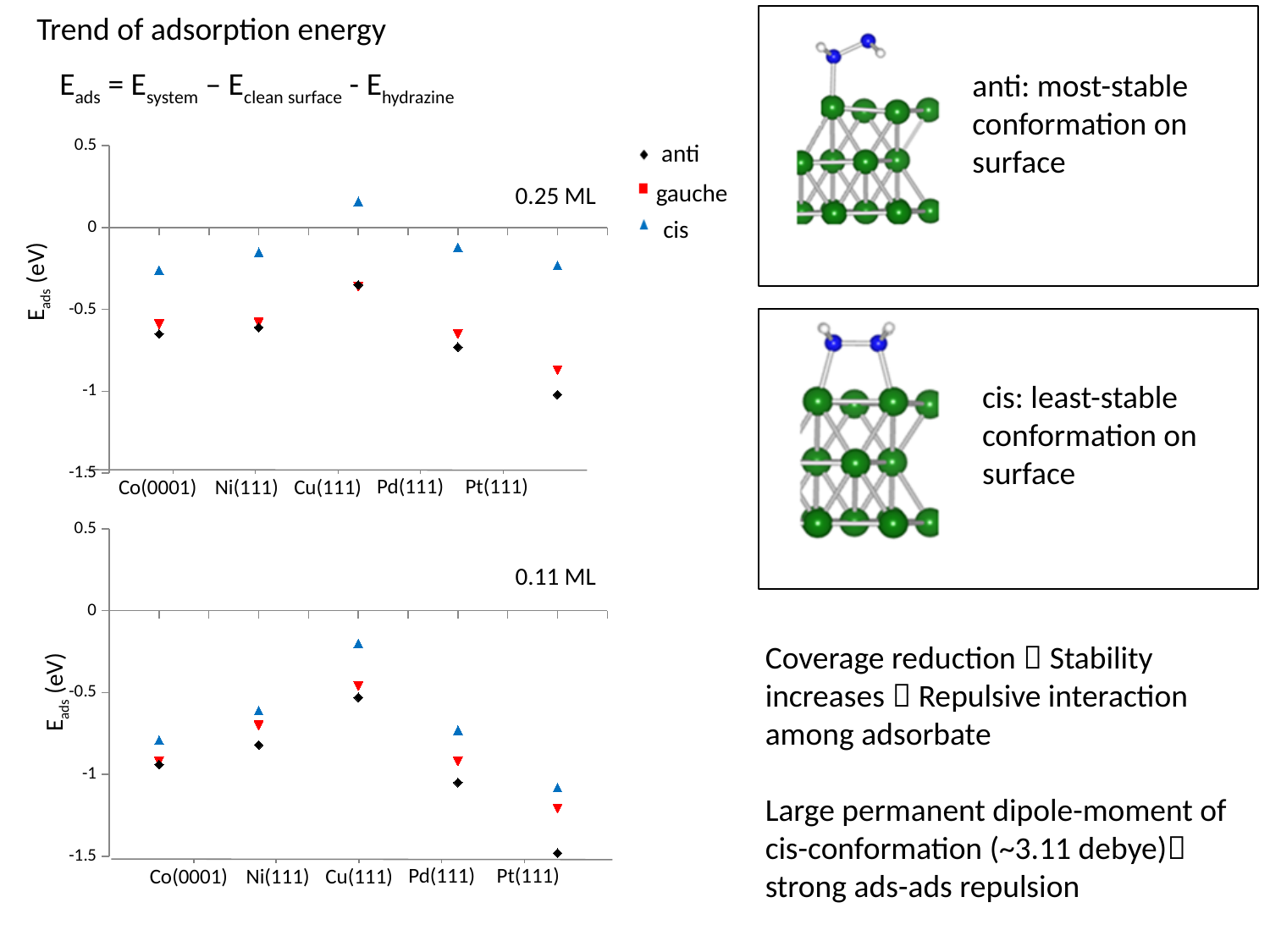
How many series does the legend of the top chart list? 3 In the bottom chart (0.11 ML), which surface has the highest cis value? Cu(111) What kind of chart is the top chart labelled 0.25 ML? scatter chart In the top chart (0.25 ML), which surface has the highest cis value? Cu(111) In the top chart (0.25 ML), is the cis value for Cu(111) greater or less than 0? greater In the bottom chart (0.11 ML), do the anti values rise or fall from Cu(111) to Pt(111)? fall In the bottom chart (0.11 ML), which is larger, the cis value for Cu(111) or the cis value for Pd(111)? Cu(111) What are the three legend entries of the top chart? anti, gauche, cis In the bottom chart (0.11 ML), is the anti value for Pt(111) greater or less than -1? less How many surfaces are plotted along the x axis of the bottom chart labelled 0.11 ML? 5 In the top chart (0.25 ML), which surface has the lowest anti value? Pt(111)